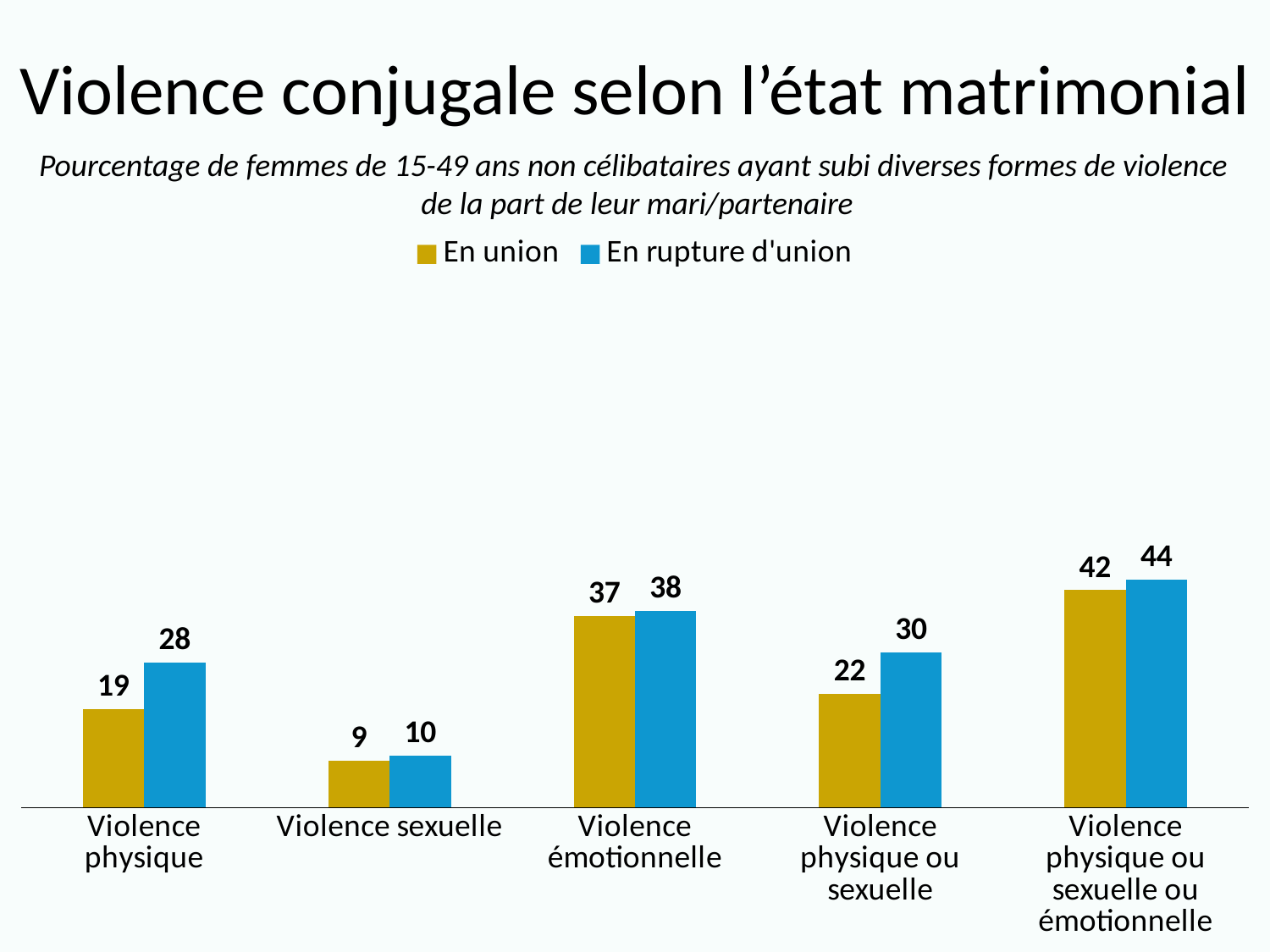
What is the value for "En union" for Violence physique? 19 What is the value for "En rupture d'union" for Violence physique ou sexuelle? 30 Which series is shown in blue? En rupture d'union What is the difference between "En rupture d'union" and "En union" for Violence physique? 9 Which category has the lowest value for "En union"? Violence sexuelle What is the difference between "En rupture d'union" and "En union" for Violence physique ou sexuelle? 8 What kind of chart is shown on the slide? Bar chart How many series does the legend list? 2 How many categories are shown on the x axis? 5 What is the value for "En union" for Violence émotionnelle? 37 Which is larger for Violence physique ou sexuelle ou émotionnelle: "En union" or "En rupture d'union"? En rupture d'union Which category has the highest value for "En rupture d'union"? Violence physique ou sexuelle ou émotionnelle